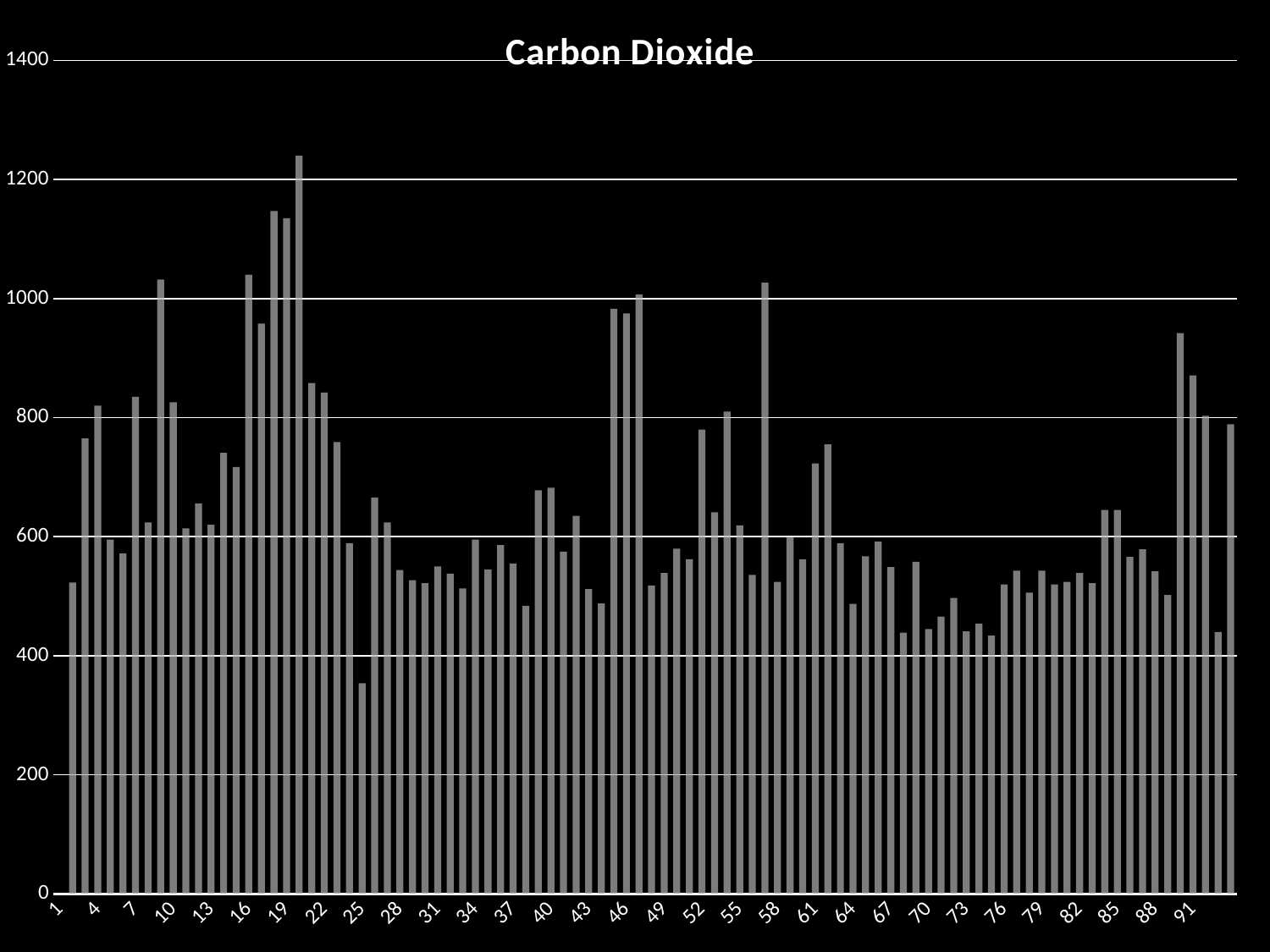
What kind of chart is shown on the slide? bar chart Is the shortest bar in the chart greater or less than 400? less What is the highest value shown on the vertical axis? 1400 Which is larger, the first bar or the last bar in the chart? the last bar Is the value of the last bar in the chart greater or less than 600? greater Is the value for category 1 (the first bar) greater or less than 600? less What is the title of the chart? Carbon Dioxide